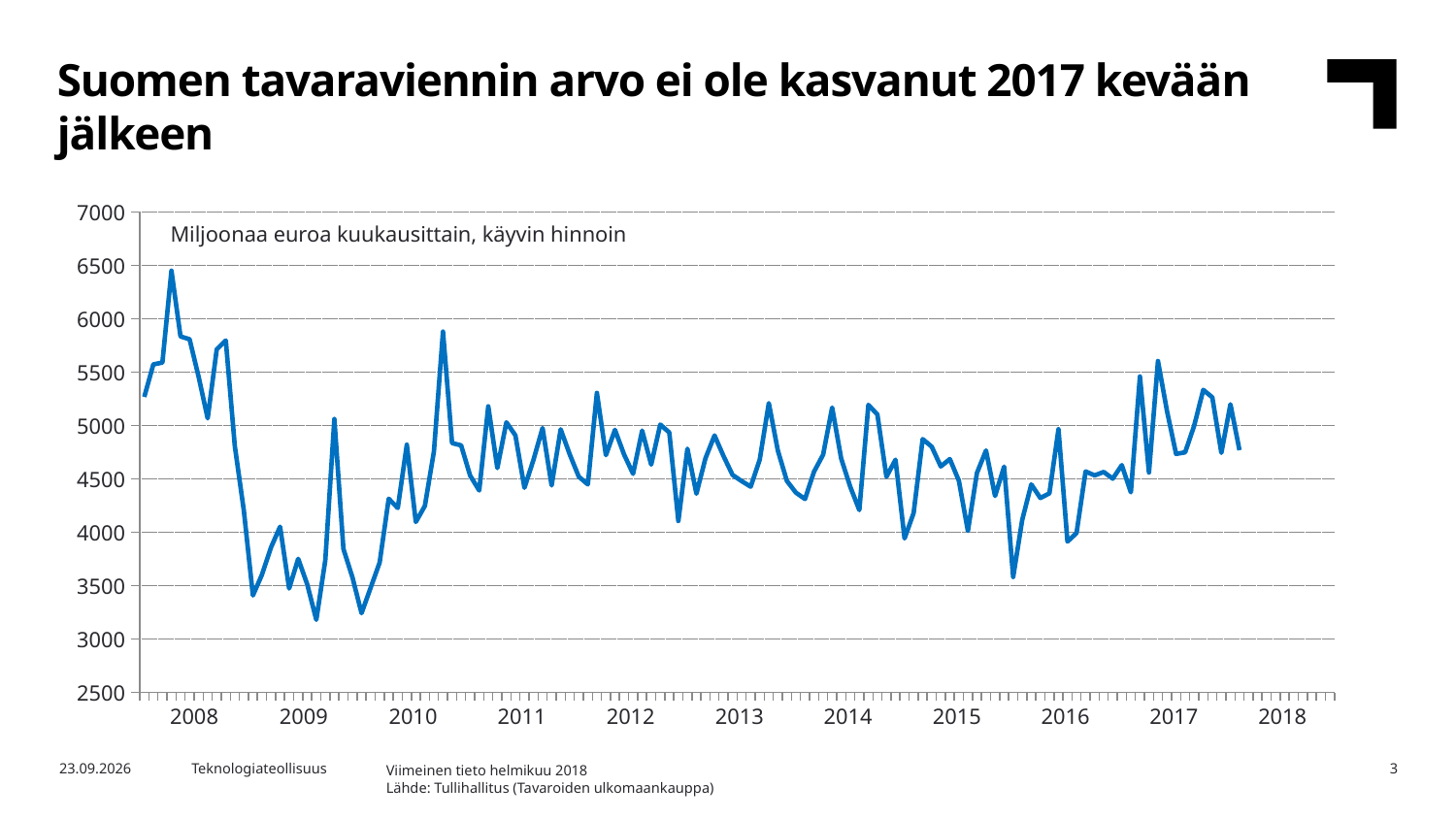
What is the highest value shown on the y axis? 7000 In which year does the line reach its highest point? 2008 How many year labels are shown on the x axis? 11 In which year does the line reach its lowest point? 2009 What kind of chart is shown on the slide? line chart What unit description is printed inside the chart area? Miljoonaa euroa kuukausittain, käyvin hinnoin What is the title of the slide? Suomen tavaraviennin arvo ei ole kasvanut 2017 kevään jälkeen Does the line generally rise or fall from the start of 2008 to the start of 2009? fall Is the lowest value in 2009 greater or less than 3500? less Which is higher, the peak in 2008 or the peak in 2017? the peak in 2008 Is the peak value in 2008 greater or less than 6000? greater What is the lowest value shown on the y axis? 2500